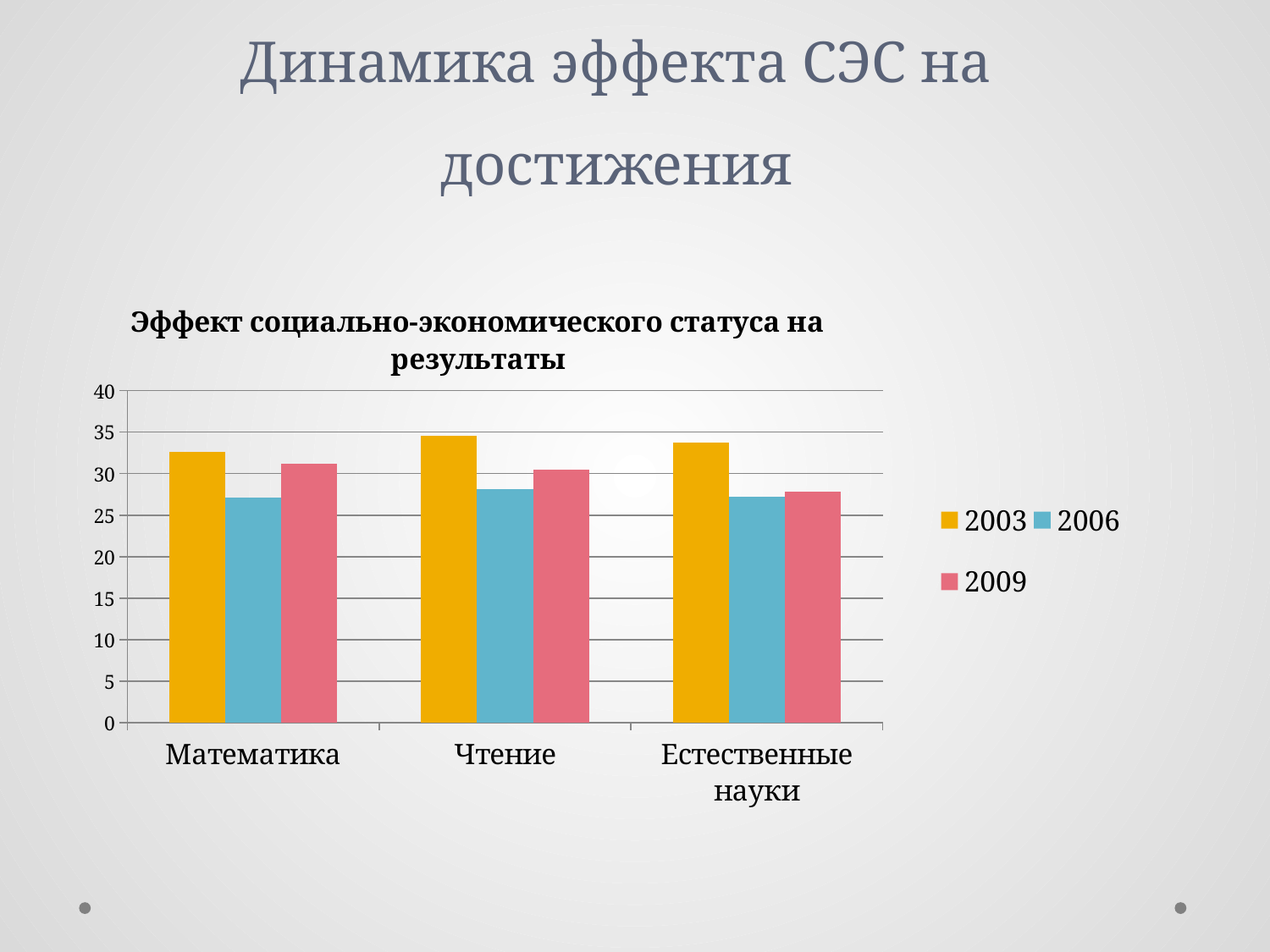
For Математика, which series has the lowest value? 2006 For the 2009 series, which category has the lowest value? Естественные науки How many categories are shown on the x axis of the chart? 3 What kind of chart is shown on the slide? bar chart Is the value for Естественные науки in 2009 greater or less than 30? less For Математика, which is larger: the value for 2003 or the value for 2006? 2003 For the 2009 series, which is larger: the value for Чтение or the value for Естественные науки? Чтение Which years are listed in the chart legend? 2003, 2006, 2009 Is the value for Математика in 2003 greater or less than 30? greater Is the value for Чтение in 2006 greater or less than 30? less What is the title of the chart? Эффект социально-экономического статуса на результаты How many series does the legend list? 3